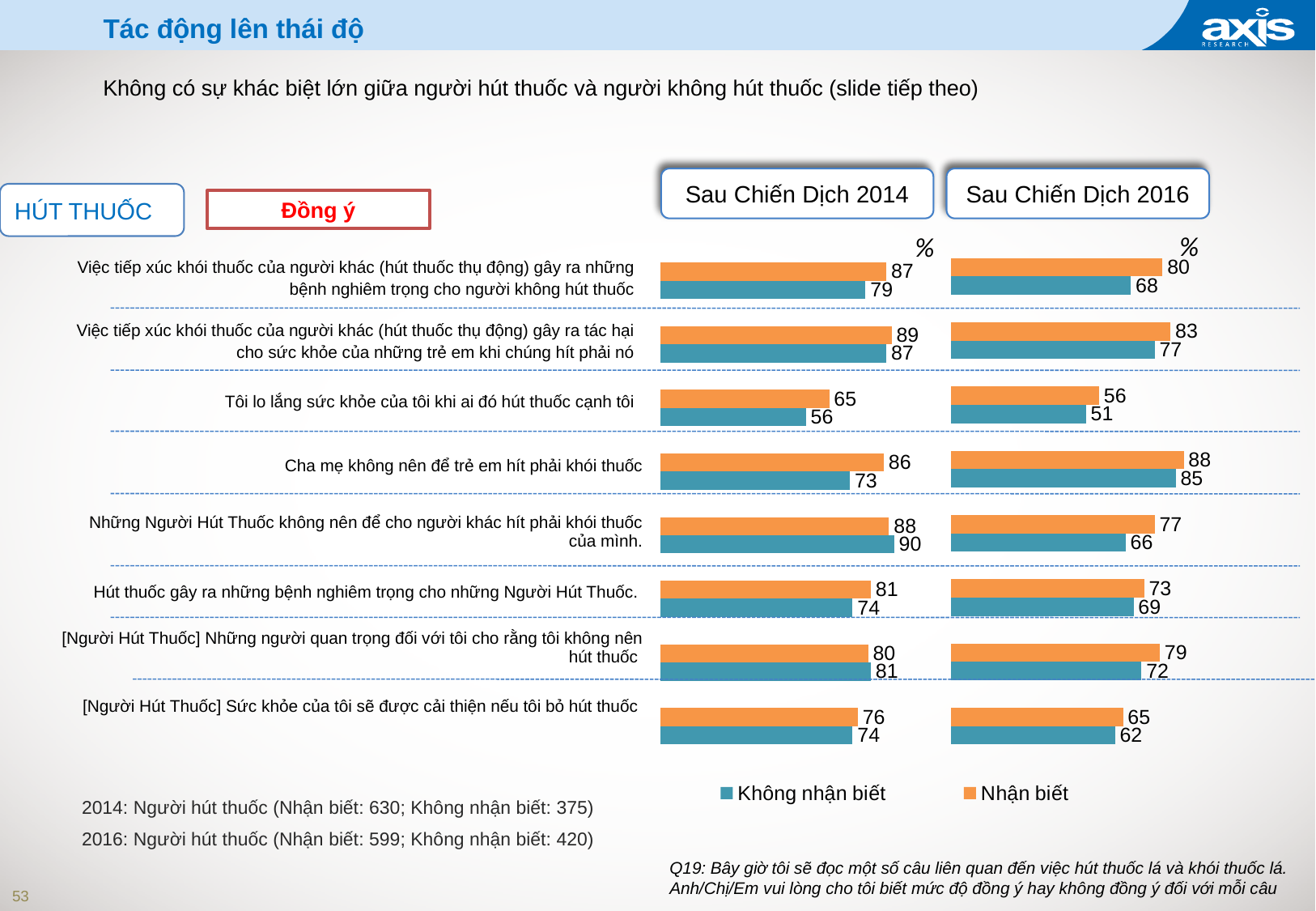
In the 'Sau Chiến Dịch 2016' chart, what is the Không nhận biết value for 'Cha mẹ không nên để trẻ em hít phải khói thuốc'? 85 In the 'Sau Chiến Dịch 2014' chart, what is the Nhận biết value for 'Tôi lo lắng sức khỏe của tôi khi ai đó hút thuốc cạnh tôi'? 65 How many series does the legend list? 2 In the 'Sau Chiến Dịch 2014' chart, what is the difference between the Nhận biết and Không nhận biết values for 'Cha mẹ không nên để trẻ em hít phải khói thuốc'? 13 In the 'Sau Chiến Dịch 2016' chart, which is larger for '[Người Hút Thuốc] Sức khỏe của tôi sẽ được cải thiện nếu tôi bỏ hút thuốc': Nhận biết or Không nhận biết? Nhận biết In the 'Sau Chiến Dịch 2014' chart, which category has the lowest Không nhận biết value? Tôi lo lắng sức khỏe của tôi khi ai đó hút thuốc cạnh tôi Which colour represents the Nhận biết series in the charts? Orange How many categories (statements) are shown in the 'Sau Chiến Dịch 2014' chart? 8 In the 'Sau Chiến Dịch 2014' chart, which is larger for 'Những Người Hút Thuốc không nên để cho người khác hít phải khói thuốc của mình.': Nhận biết or Không nhận biết? Không nhận biết What type of chart is the 'Sau Chiến Dịch 2016' chart? Bar chart In the 'Sau Chiến Dịch 2016' chart, which category has the highest Nhận biết value? Cha mẹ không nên để trẻ em hít phải khói thuốc In the 'Sau Chiến Dịch 2016' chart, what is the difference between the Nhận biết and Không nhận biết values for 'Những Người Hút Thuốc không nên để cho người khác hít phải khói thuốc của mình.'? 11